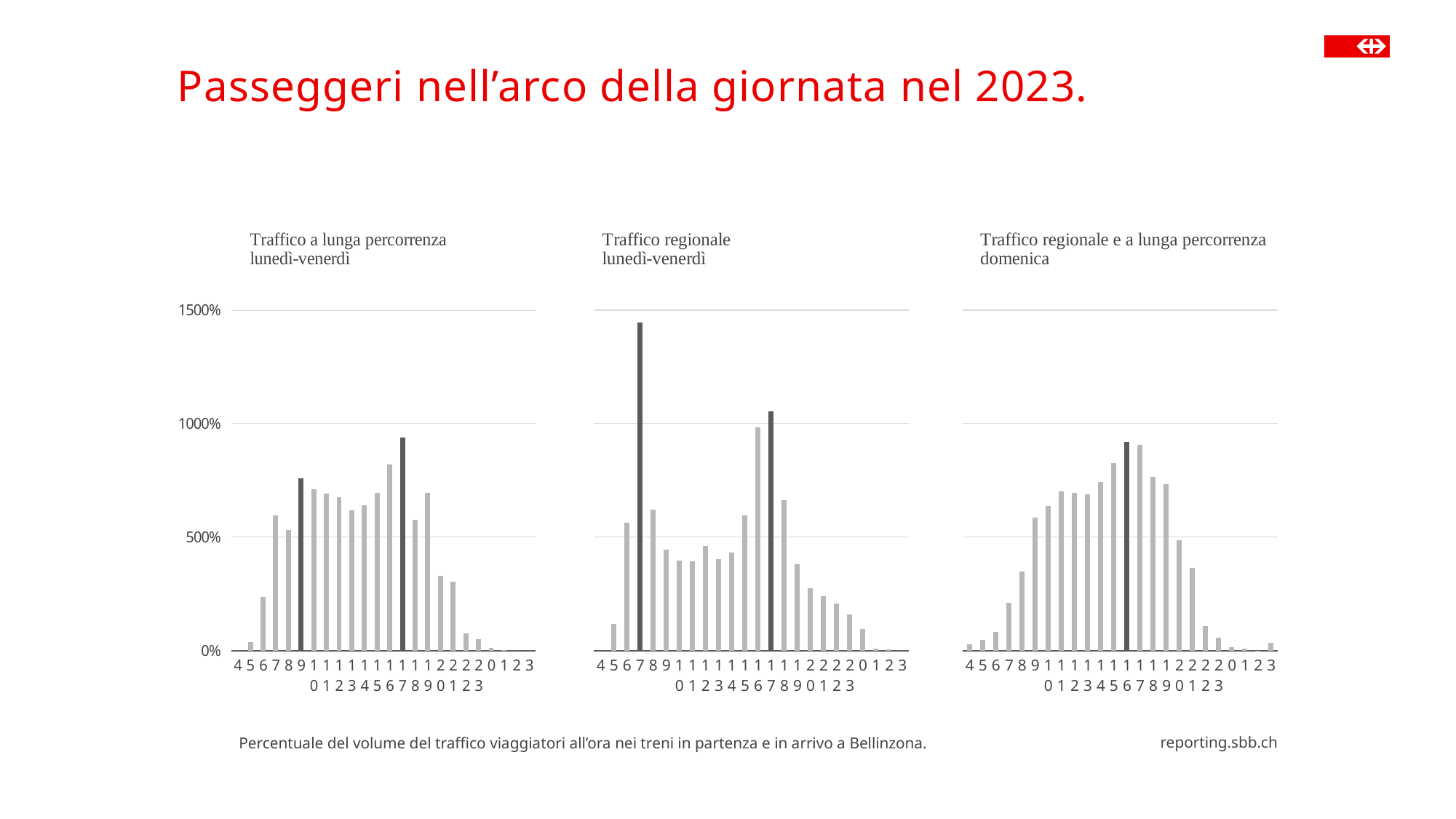
In the "Traffico regionale lunedì-venerdì" chart, which hour has the highest value? 7 How many hour categories are plotted on the x axis of the "Traffico regionale lunedì-venerdì" chart? 24 In the "Traffico a lunga percorrenza lunedì-venerdì" chart, is the value for hour 17 greater or less than 1000%? less In the "Traffico regionale e a lunga percorrenza domenica" chart, do the values rise or fall from hour 4 to hour 16? rise In the "Traffico regionale lunedì-venerdì" chart, do the values rise or fall from hour 17 to hour 23? fall In the "Traffico regionale e a lunga percorrenza domenica" chart, is the value for hour 16 greater or less than 500%? greater In the "Traffico regionale lunedì-venerdì" chart, which is larger: the value for hour 7 or the value for hour 17? hour 7 What kind of chart is the "Traffico a lunga percorrenza lunedì-venerdì" chart? bar chart In the "Traffico a lunga percorrenza lunedì-venerdì" chart, is the value for hour 5 greater or less than 500%? less In the "Traffico a lunga percorrenza lunedì-venerdì" chart, which hour has the highest value? 17 How many charts are shown on the slide? 3